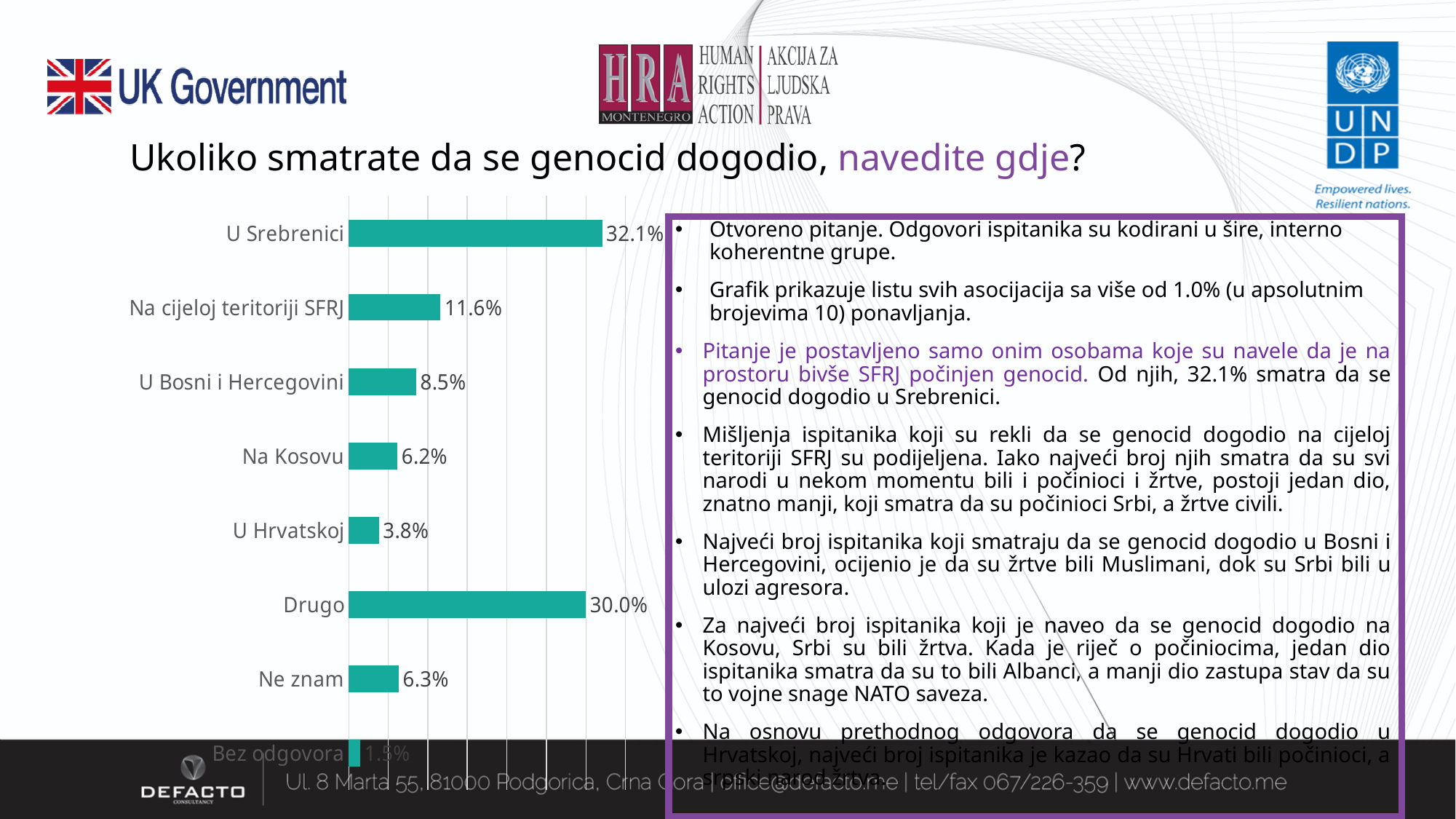
Which is larger, the value for "Na cijeloj teritoriji SFRJ" or the value for "U Bosni i Hercegovini"? Na cijeloj teritoriji SFRJ Which category has the lowest value in the chart? Bez odgovora What is the value shown for "U Hrvatskoj"? 3.8% What is the value shown for "Na cijeloj teritoriji SFRJ"? 11.6% What is the difference between the values for "U Bosni i Hercegovini" and "Na Kosovu"? 2.3% What percentage of respondents answered "U Srebrenici"? 32.1% Which category has the highest value in the chart? U Srebrenici What colour are the bars in the chart? Teal What type of chart is shown on the slide? Bar chart What is the difference between the values for "U Srebrenici" and "Drugo"? 2.1% What is the value shown for "Drugo"? 30.0% How many categories are shown in the chart? 8